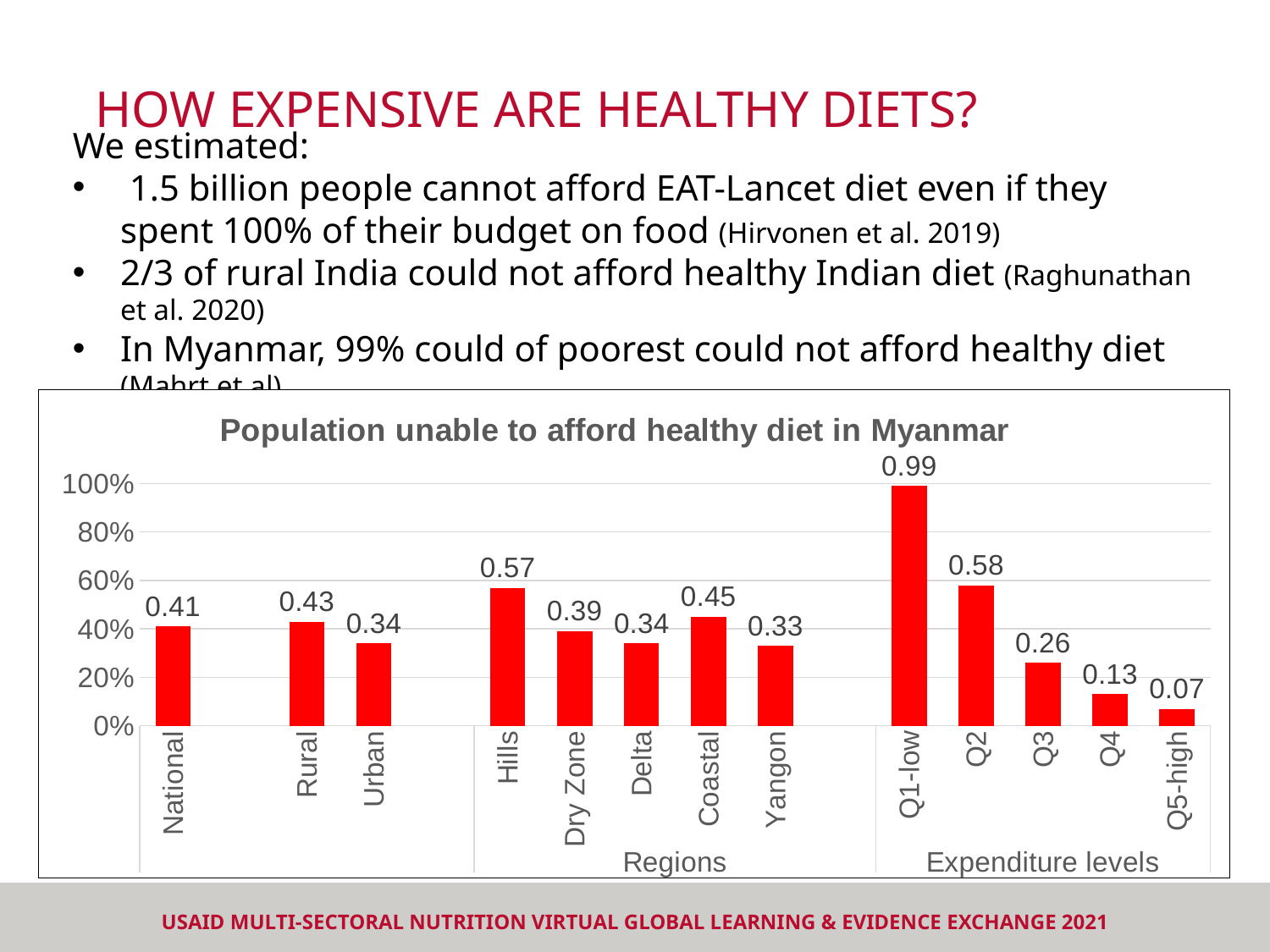
What kind of chart is shown on the slide? Bar chart What is the value for Hills in the chart? 0.57 How many bars are plotted in the chart? 13 What is the value for Q1-low in the chart? 0.99 What is the difference between the values for Rural and Urban? 0.09 Which category has the lowest value in the chart? Q5-high Which category has the highest value in the chart? Q1-low What is the value for National in the chart? 0.41 What is the title of the chart? Population unable to afford healthy diet in Myanmar Is the value for Q2 greater or less than 40%? greater Do the values fall or rise from Q1-low to Q5-high? Fall Which is larger, the value for Coastal or the value for Yangon? Coastal